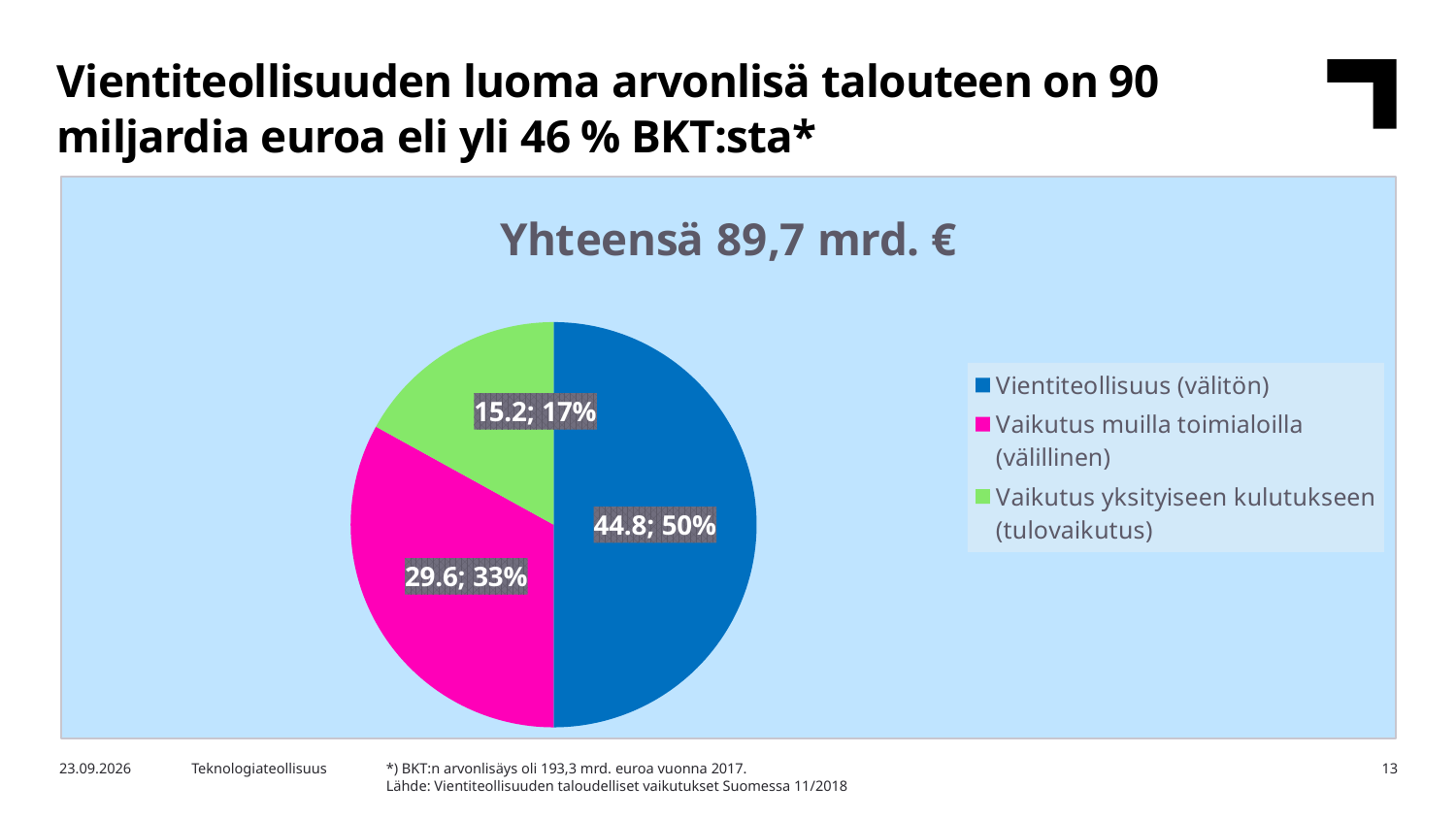
What value is shown for Vaikutus muilla toimialoilla (välillinen)? 29.6 What is the difference between the values for Vientiteollisuus (välitön) and Vaikutus muilla toimialoilla (välillinen)? 15.2 What share of the pie does Vientiteollisuus (välitön) represent? 50% What value is shown for Vaikutus yksityiseen kulutukseen (tulovaikutus)? 15.2 How many slices does the pie chart have? 3 What share of the pie does Vaikutus yksityiseen kulutukseen (tulovaikutus) represent? 17% What is the title of the chart? Yhteensä 89,7 mrd. € Which slice is the smallest? Vaikutus yksityiseen kulutukseen (tulovaikutus) What value is shown for Vientiteollisuus (välitön)? 44.8 How many entries does the legend list? 3 Which slice is the largest? Vientiteollisuus (välitön) What kind of chart is shown on the slide? Pie chart